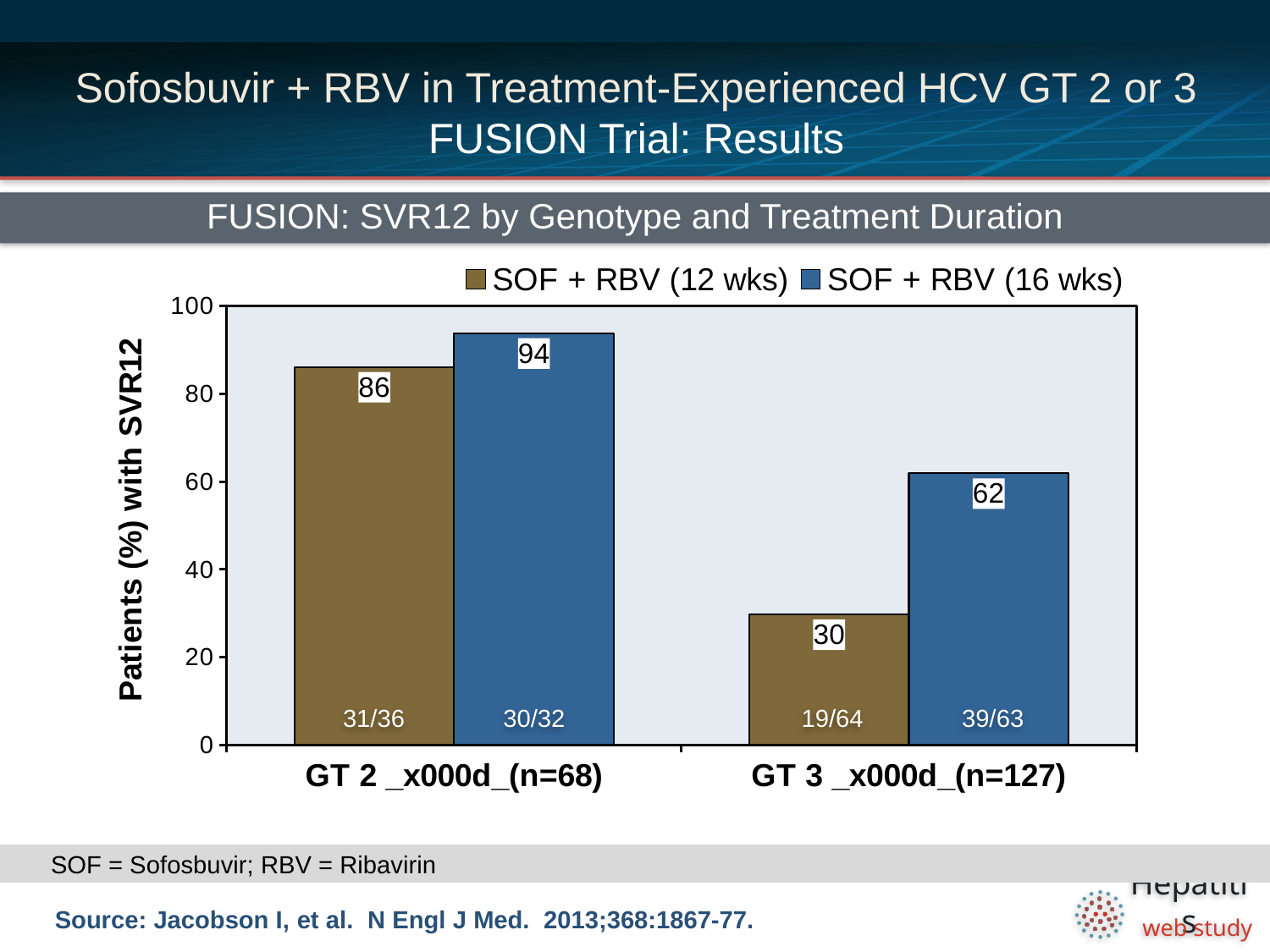
How many genotype groups are shown on the x axis? 2 What is the SVR12 rate for SOF + RBV (12 wks) in GT 2 patients? 86 What is the difference in SVR12 rate between the 16-week and 12-week arms in GT 2 patients? 8 What is the SVR12 rate for SOF + RBV (16 wks) in GT 3 patients? 62 What is the SVR12 rate for SOF + RBV (12 wks) in GT 3 patients? 30 Which bar has the lowest SVR12 rate? SOF + RBV (12 wks) in GT 3 Which is larger: the SVR12 rate for SOF + RBV (12 wks) in GT 2 or for SOF + RBV (16 wks) in GT 3? SOF + RBV (12 wks) in GT 2 What kind of chart is shown? Bar chart How many series does the legend list? 2 What is the difference in SVR12 rate between the 16-week and 12-week arms in GT 3 patients? 32 Which bar has the highest SVR12 rate? SOF + RBV (16 wks) in GT 2 What is the label of the y axis? Patients (%) with SVR12